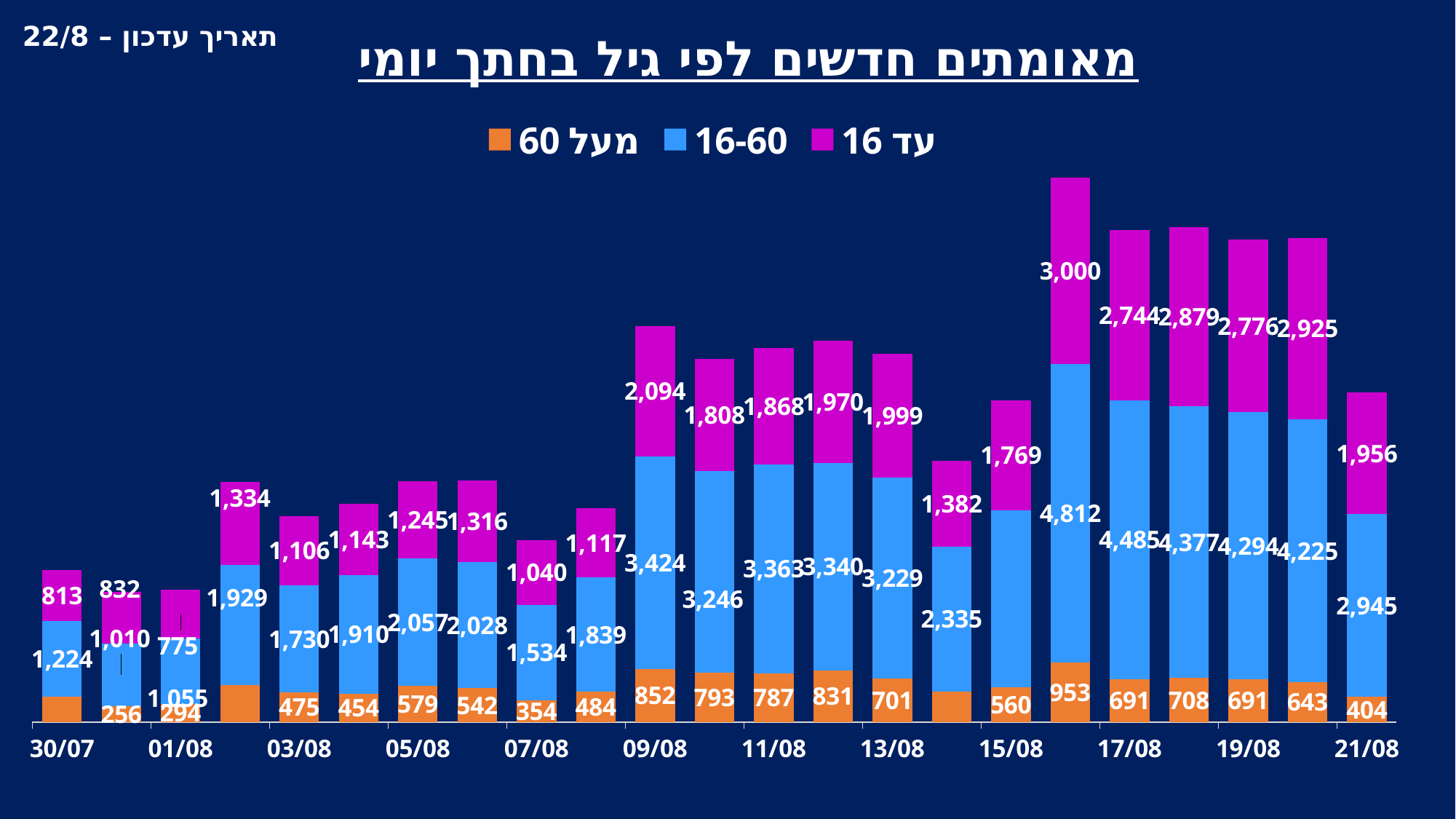
Which is larger: the 16-60 value on 09/08 or on 11/08? 09/08 What is the total of the stacked bar for 21/08? 5,305 How many daily bars are plotted in the chart? 23 What is the highest value shown for the 16-60 series? 4,812 What is the difference between the 16-60 values on 17/08 and 19/08? 191 What is the value of the מעל 60 series on 13/08? 701 How many series does the legend list? 3 What type of chart is shown on the slide? Stacked bar chart What is the highest value shown for the עד 16 series? 3,000 What is the value of the עד 16 series on 09/08? 2,094 What is the value of the 16-60 series on 21/08? 2,945 What is the value of the 16-60 series on 03/08? 1,730